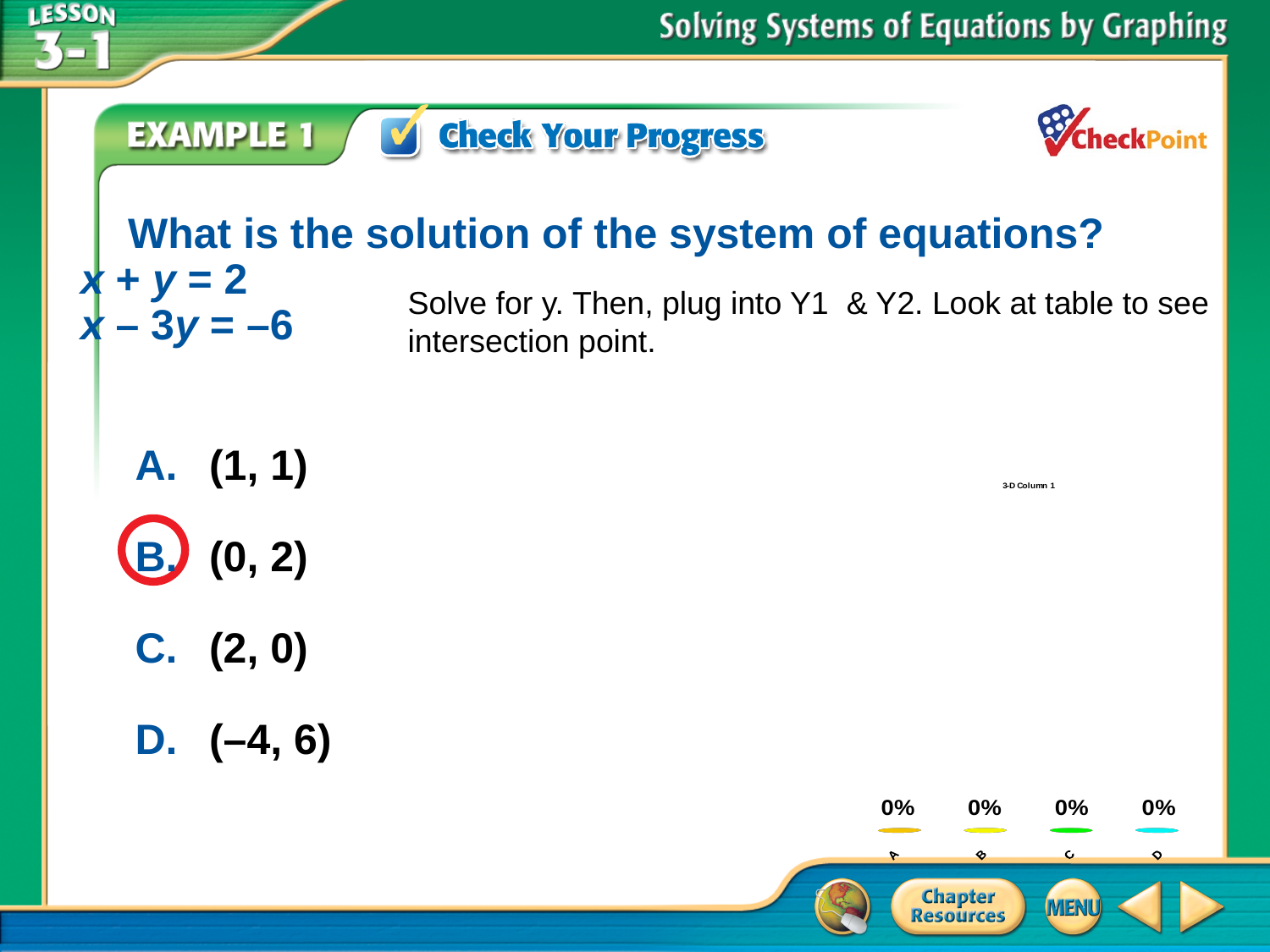
What is the value shown for category B? 0% What is the value shown for category A? 0% What are the category labels along the bottom of the chart? A, B, C, D What is the value shown for category D? 0% How many categories does the chart show? 4 What is the difference between the values for A and D? 0% What kind of chart is shown on the slide? bar chart What is the value shown for category C? 0%